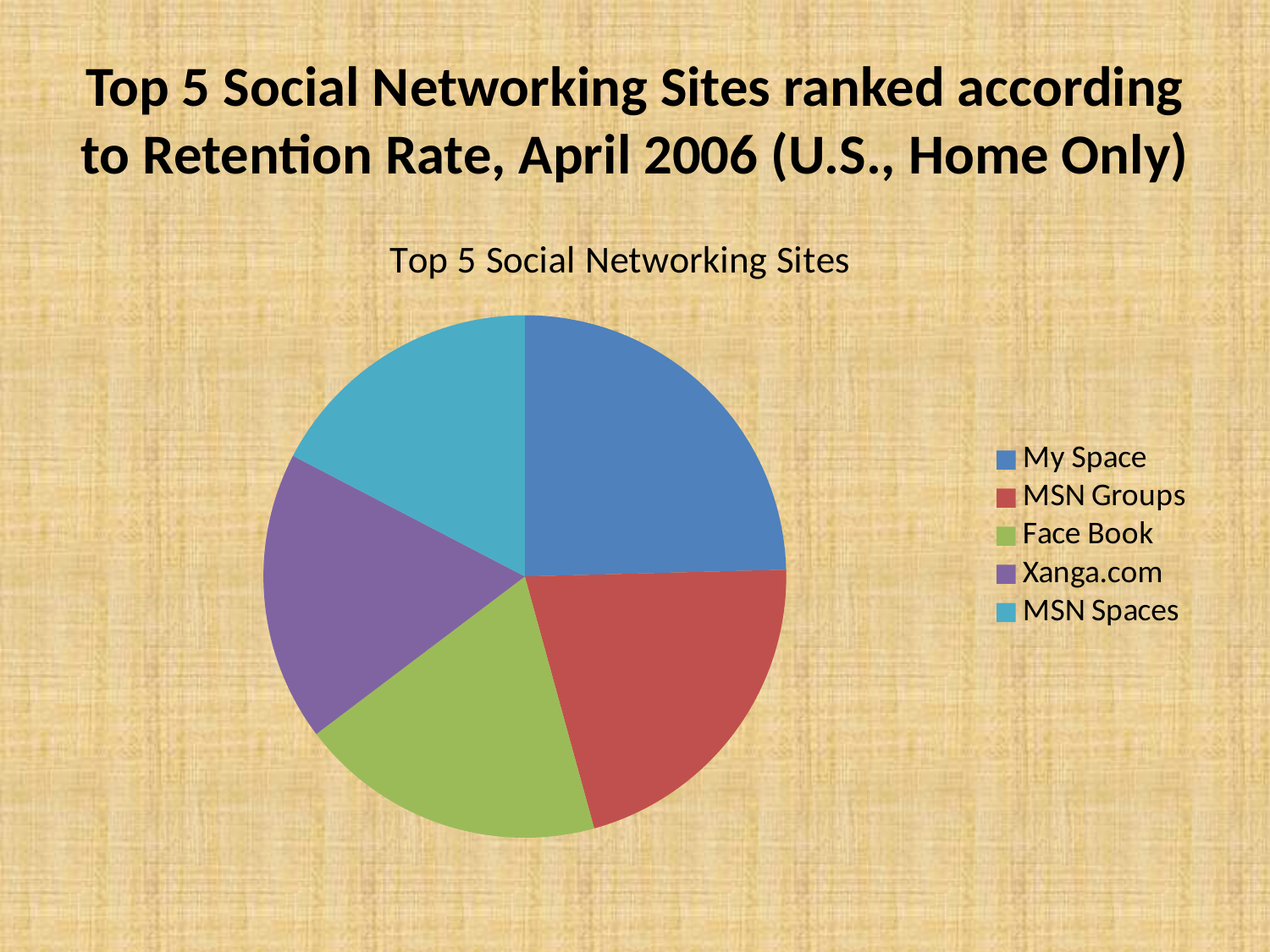
Which site is shown in the green slice of the pie chart? Face Book Which slice is larger, My Space or MSN Spaces? My Space What is the title of the pie chart? Top 5 Social Networking Sites How many slices does the pie chart have? 5 Which slice is larger, MSN Groups or MSN Spaces? MSN Groups How many entries does the legend list? 5 Which slice is larger, My Space or Xanga.com? My Space Which site has the largest slice in the pie chart? My Space What kind of chart is shown on the slide? Pie chart